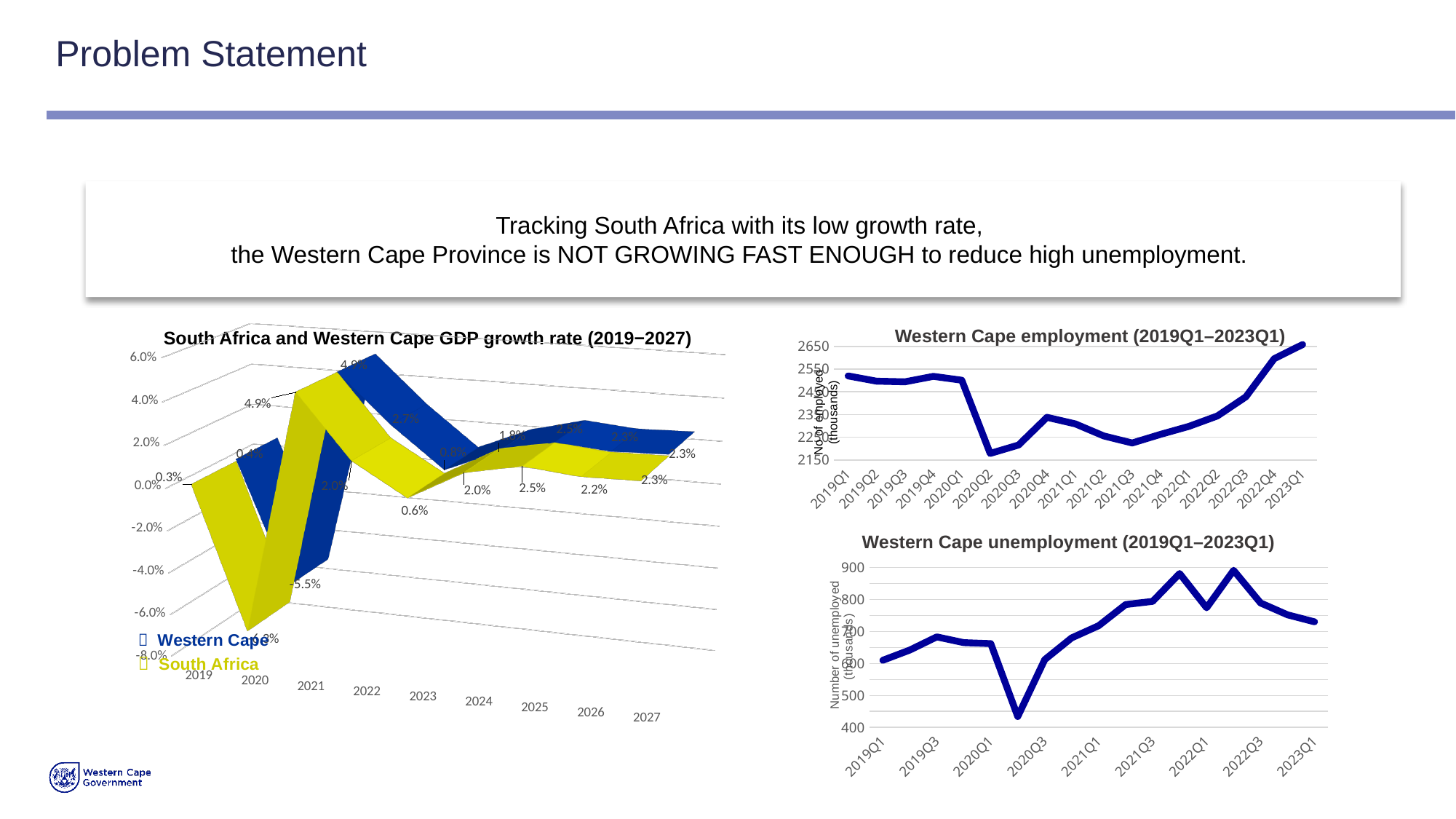
In the 'Western Cape employment (2019Q1–2023Q1)' chart, which quarter has the highest employment? 2023Q1 In the 'South Africa and Western Cape GDP growth rate (2019−2027)' chart, what is the difference between the Western Cape's 2022 growth rate and South Africa's 2022 growth rate? 0.7 percentage points In the 'South Africa and Western Cape GDP growth rate (2019−2027)' chart, which year has the highest growth rate for South Africa? 2021 In the 'South Africa and Western Cape GDP growth rate (2019−2027)' chart, what is South Africa's GDP growth rate for 2021? 4.9% In the 'South Africa and Western Cape GDP growth rate (2019−2027)' chart, what is the Western Cape's GDP growth rate for 2020? -5.5% What kind of chart is 'Western Cape employment (2019Q1–2023Q1)'? Line chart In the 'South Africa and Western Cape GDP growth rate (2019−2027)' chart, which series has the larger value in 2023, Western Cape or South Africa? Western Cape How many series does the legend of the 'South Africa and Western Cape GDP growth rate (2019−2027)' chart list? 2 How many years are shown on the x axis of the 'South Africa and Western Cape GDP growth rate (2019−2027)' chart? 9 In the 'Western Cape unemployment (2019Q1–2023Q1)' chart, is the value for 2020Q2 greater or less than 500? less In the 'South Africa and Western Cape GDP growth rate (2019−2027)' chart, what is South Africa's GDP growth rate for 2023? 0.6% In the 'Western Cape employment (2019Q1–2023Q1)' chart, is the value for 2020Q2 greater or less than 2250? less